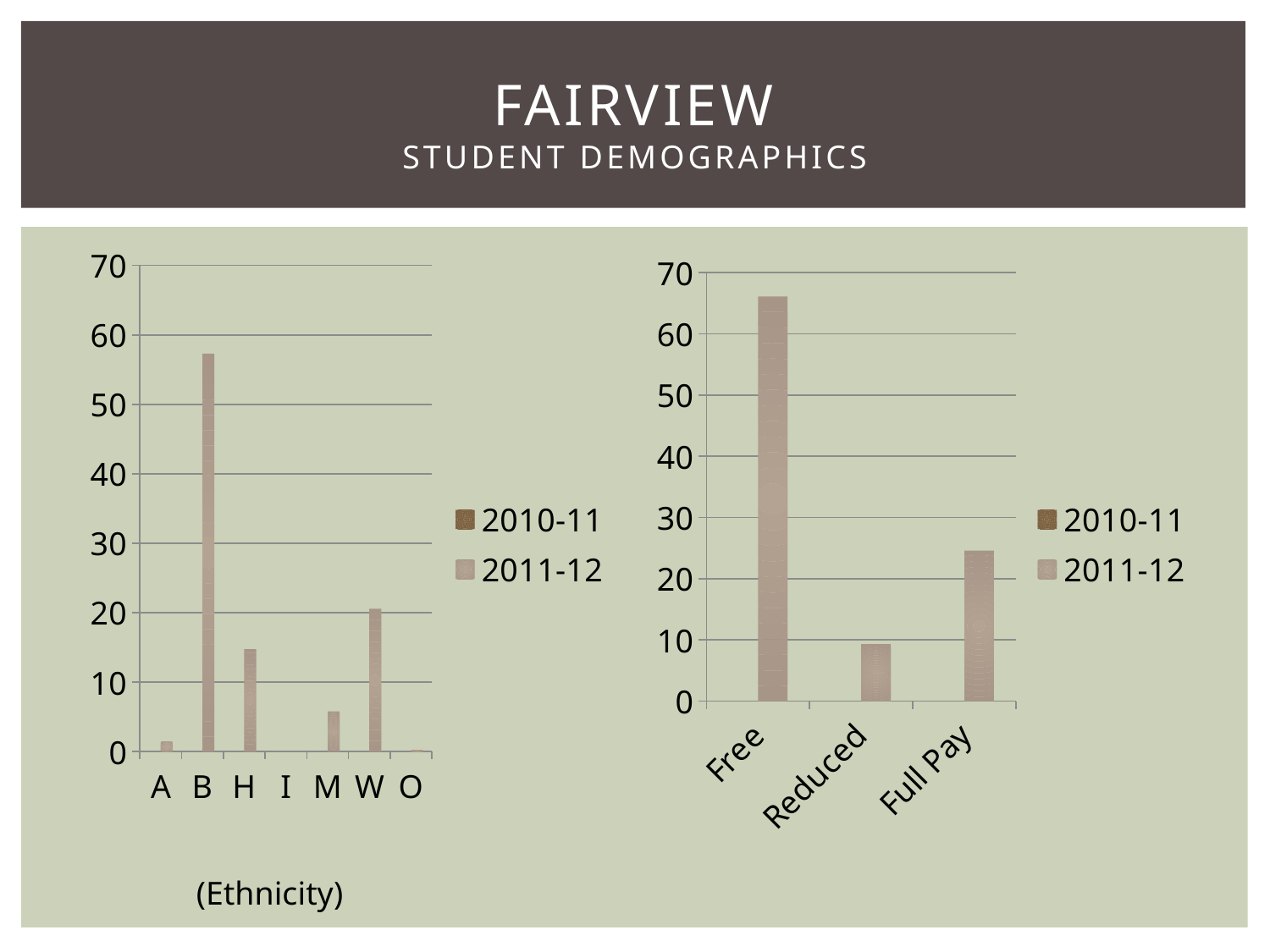
On the left (Ethnicity) chart, is the value for H greater or less than 10? greater What kind of chart is the right chart? Bar chart On the left (Ethnicity) chart, which is larger, the value for H or the value for W? W On the left (Ethnicity) chart, is the value for W greater or less than 30? less On the right chart, is the value for Free greater or less than 60? greater How many series does the legend of the left (Ethnicity) chart list? 2 On the right chart, which category has the lowest value? Reduced On the left (Ethnicity) chart, which category has the highest value? B How many categories are shown on the x axis of the left (Ethnicity) chart? 7 On the right chart, which category has the highest value? Free